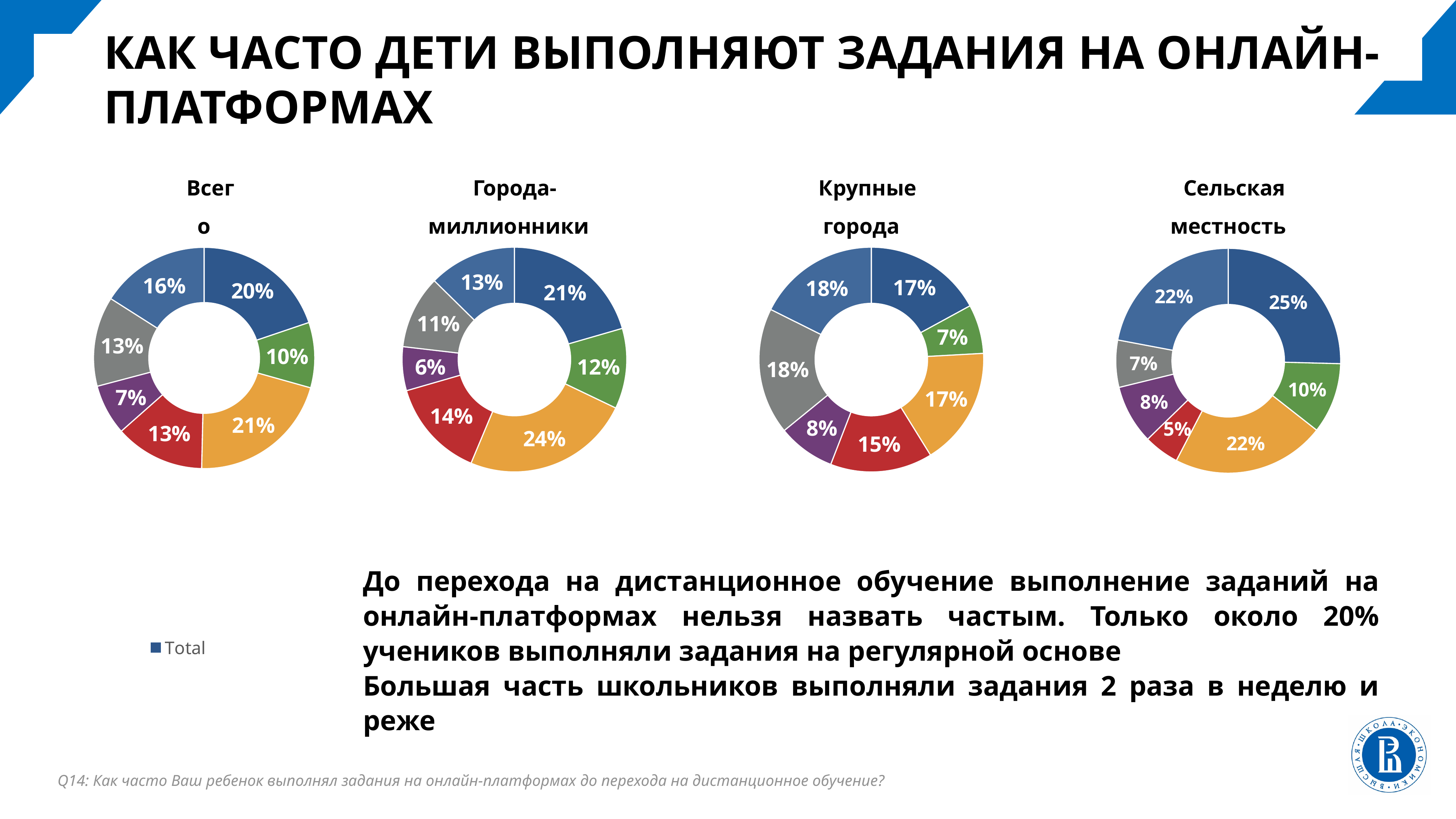
How many charts are shown on the slide? 4 What kind of chart is used on this slide? Doughnut (pie) chart In the "Крупные города" chart, which slice has the smallest value? The green slice (7%) In the "Города-миллионники" chart, what is the value of the purple slice? 6% In the "Сельская местность" chart, which slice has the smallest value? The red slice (5%) In the "Сельская местность" chart, what is the value of the dark blue slice? 25% In the "Города-миллионники" chart, which slice has the largest value? The orange slice (24%) In the "Всего" chart, what is the value of the orange slice? 21% In the "Сельская местность" chart, which is larger: the green slice or the grey slice? The green slice (10%) How many slices does the "Всего" chart have? 7 In the "Всего" chart, what is the difference between the orange slice and the green slice? 11 percentage points In the "Крупные города" chart, what is the value of the red slice? 15%